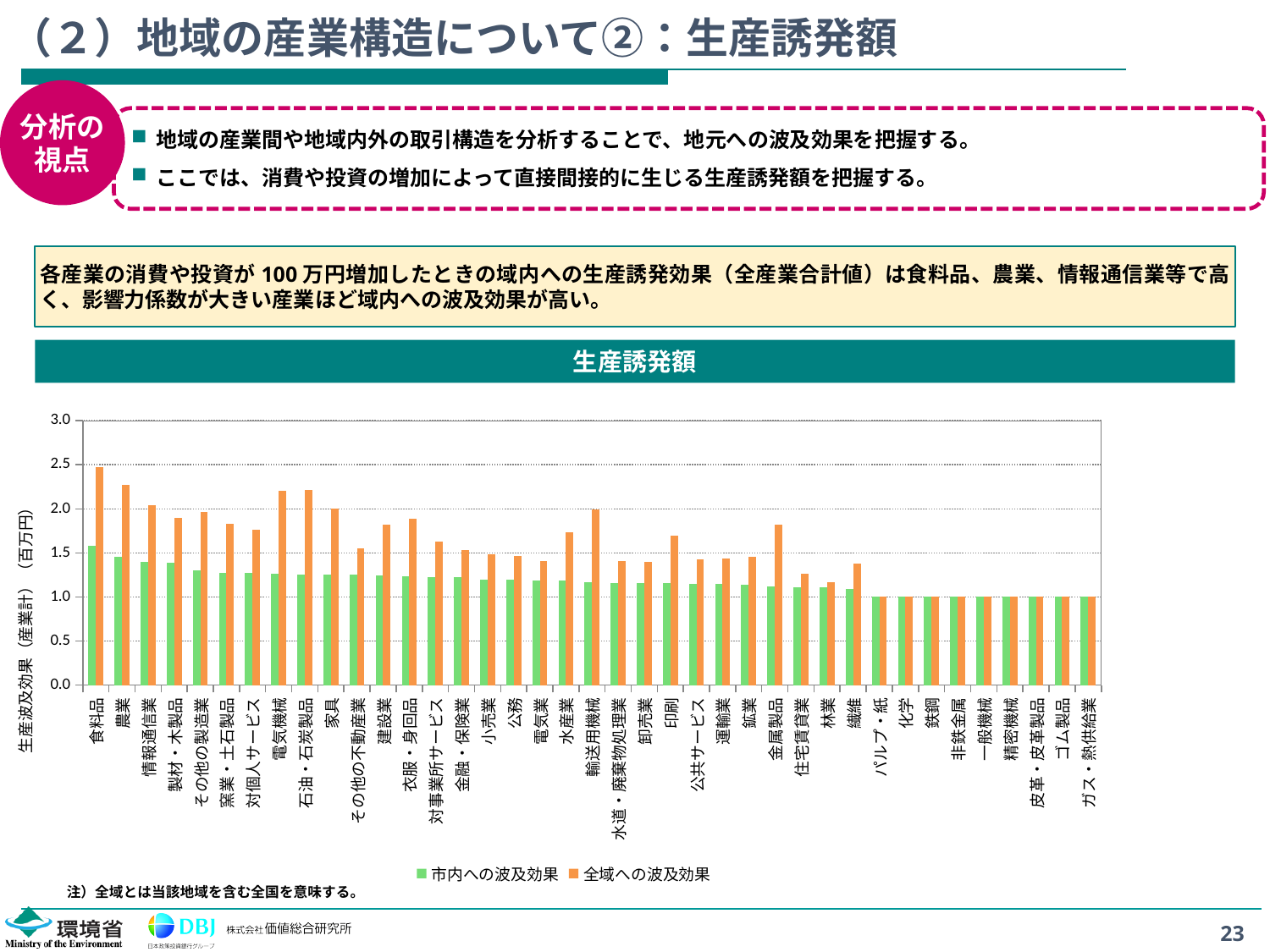
Is the 全域への波及効果 value for 電気機械 greater or less than 2.0? greater What kind of chart is shown under the title 生産誘発額? bar chart Which industry has the highest 市内への波及効果 value in the 生産誘発額 chart? 食料品 Which industry has the highest 全域への波及効果 value in the 生産誘発額 chart? 食料品 Is the 市内への波及効果 value for 農業 greater or less than 1.5? less How many industry categories are plotted along the x axis of the 生産誘発額 chart? 39 How many series does the legend of the 生産誘発額 chart list? 2 Is the 全域への波及効果 value for 食料品 greater or less than 2.0? greater Which is larger for 金属製品: the 市内への波及効果 value or the 全域への波及効果 value? 全域への波及効果 Do the 市内への波及効果 values generally rise or fall moving from left to right along the x axis? fall What is the label of the y axis of the 生産誘発額 chart? 生産波及効果（産業計）（百万円） Which colour represents 全域への波及効果 in the 生産誘発額 chart? orange